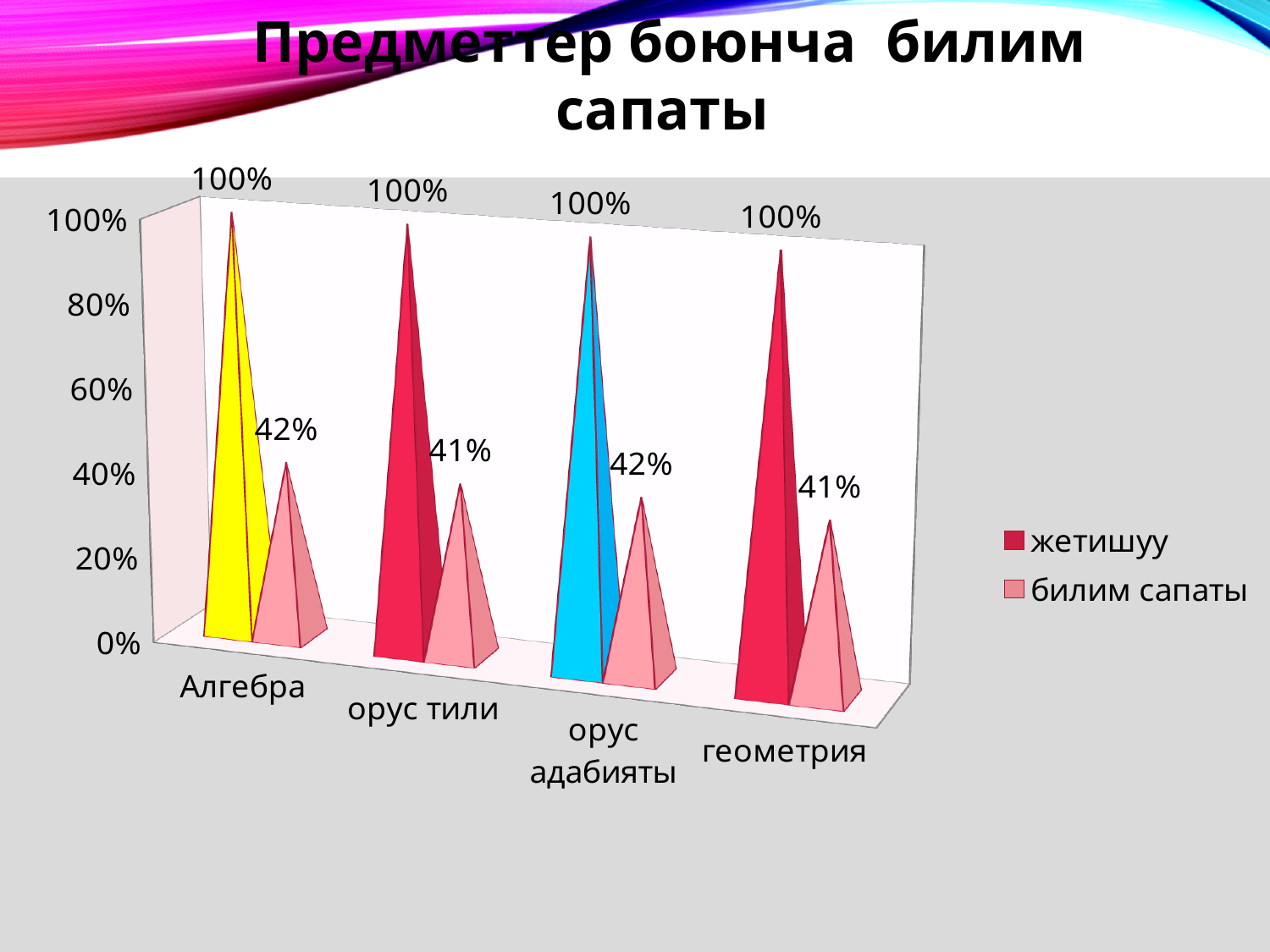
What is the билим сапаты value for геометрия? 41% What is the билим сапаты value for орус тили? 41% How many subject categories are shown on the x axis? 4 What is the difference between the жетишуу and билим сапаты values for орус тили? 59% What is the difference between the жетишуу and билим сапаты values for Алгебра? 58% What are the two series named in the legend? жетишуу and билим сапаты What is the билим сапаты value for орус адабияты? 42% What is the жетишуу value for геометрия? 100% What kind of chart is shown on the slide? bar chart How many series does the legend list? 2 What is the билим сапаты value for Алгебра? 42% Which is larger, the билим сапаты value for Алгебра or for орус тили? Алгебра